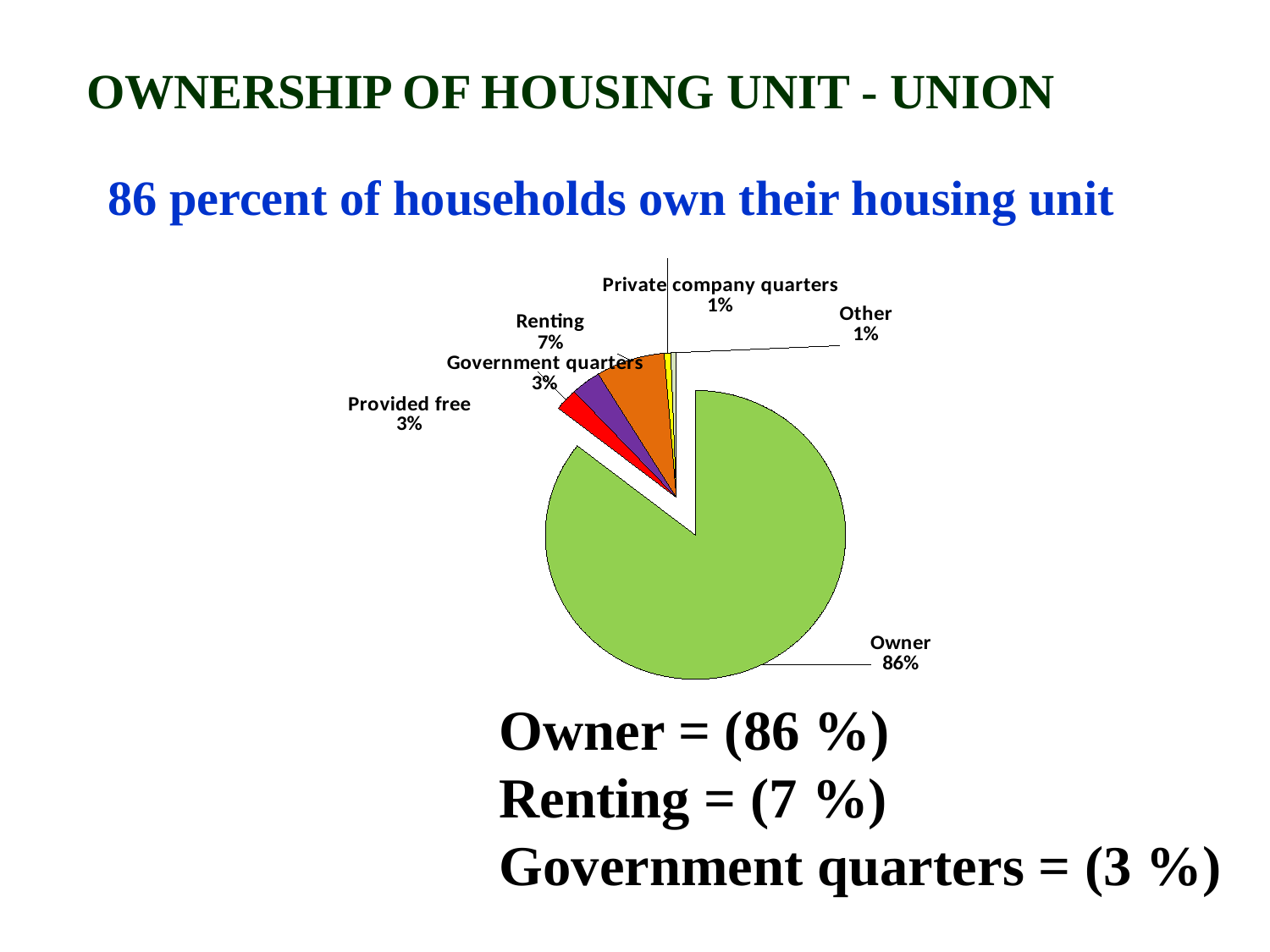
What is the difference in percentage points between Owner and Renting? 79 How many slices does the pie chart have? 6 Which is larger, Renting or Government quarters? Renting What percentage is shown for Provided free? 3% What percentage of households are renting? 7% What percentage is shown for Other? 1% What is the title of the slide containing the chart? OWNERSHIP OF HOUSING UNIT - UNION Which category has the largest slice of the pie? Owner What percentage is shown for Private company quarters? 1% What type of chart is shown on the slide? pie chart What percentage is shown for Government quarters? 3% What share of households are owners according to the pie chart? 86%